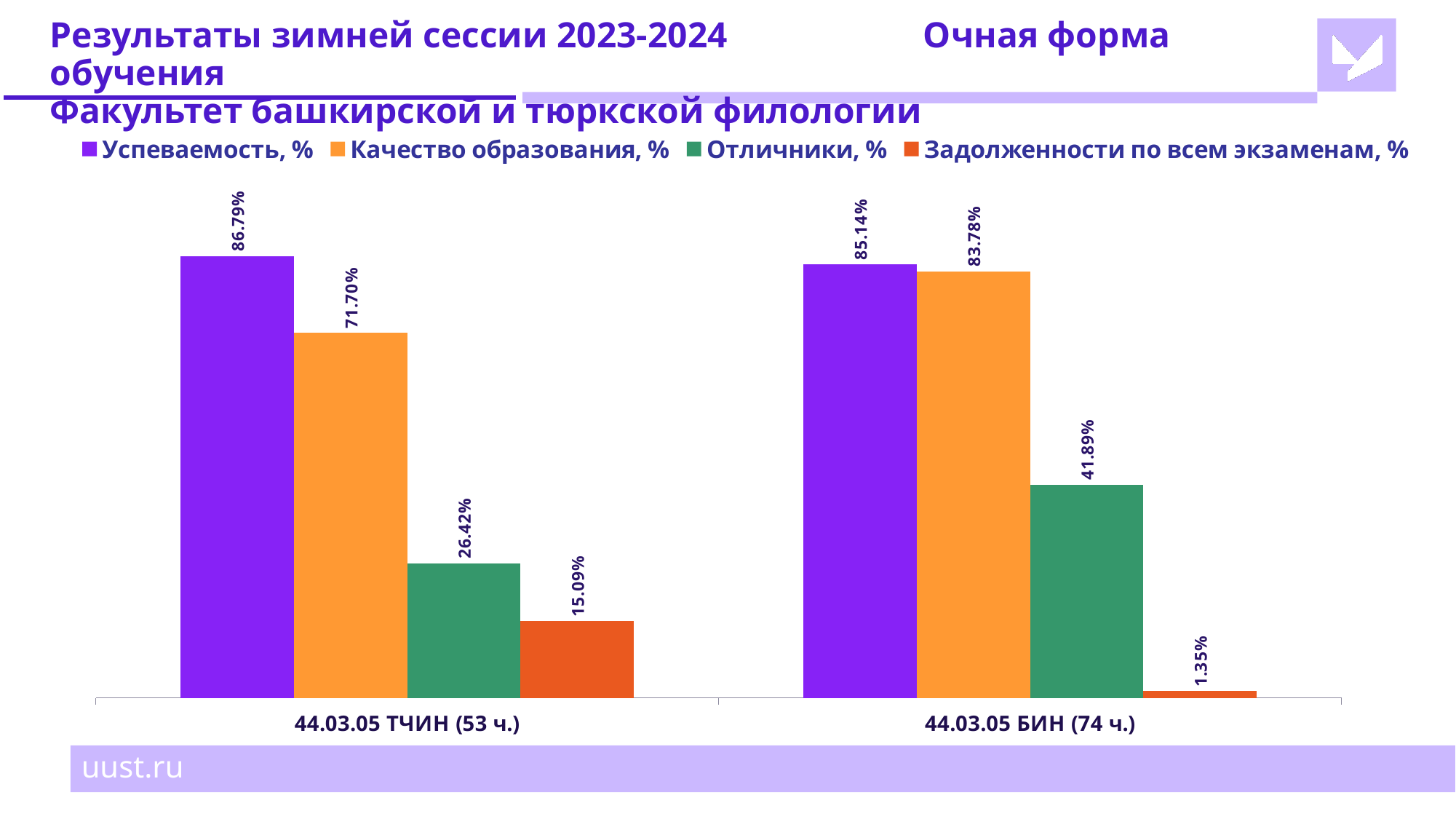
What is the value of Отличники, % for 44.03.05 ТЧИН (53 ч.)? 26.42% What kind of chart is shown on the slide? Bar chart What is the difference between Успеваемость, % for 44.03.05 ТЧИН (53 ч.) and for 44.03.05 БИН (74 ч.)? 1.65% What is the value of Задолженности по всем экзаменам, % for 44.03.05 БИН (74 ч.)? 1.35% What is the difference between Качество образования, % and Отличники, % for 44.03.05 БИН (74 ч.)? 41.89% What is the value of Качество образования, % for 44.03.05 БИН (74 ч.)? 83.78% Which category has the lower value for Задолженности по всем экзаменам, %? 44.03.05 БИН (74 ч.) Which series is shown in orange in the legend? Качество образования, % Which category has the higher value for Отличники, %? 44.03.05 БИН (74 ч.) What is the value of Успеваемость, % for 44.03.05 ТЧИН (53 ч.)? 86.79% How many series does the legend list? 4 How many categories are shown on the x axis? 2